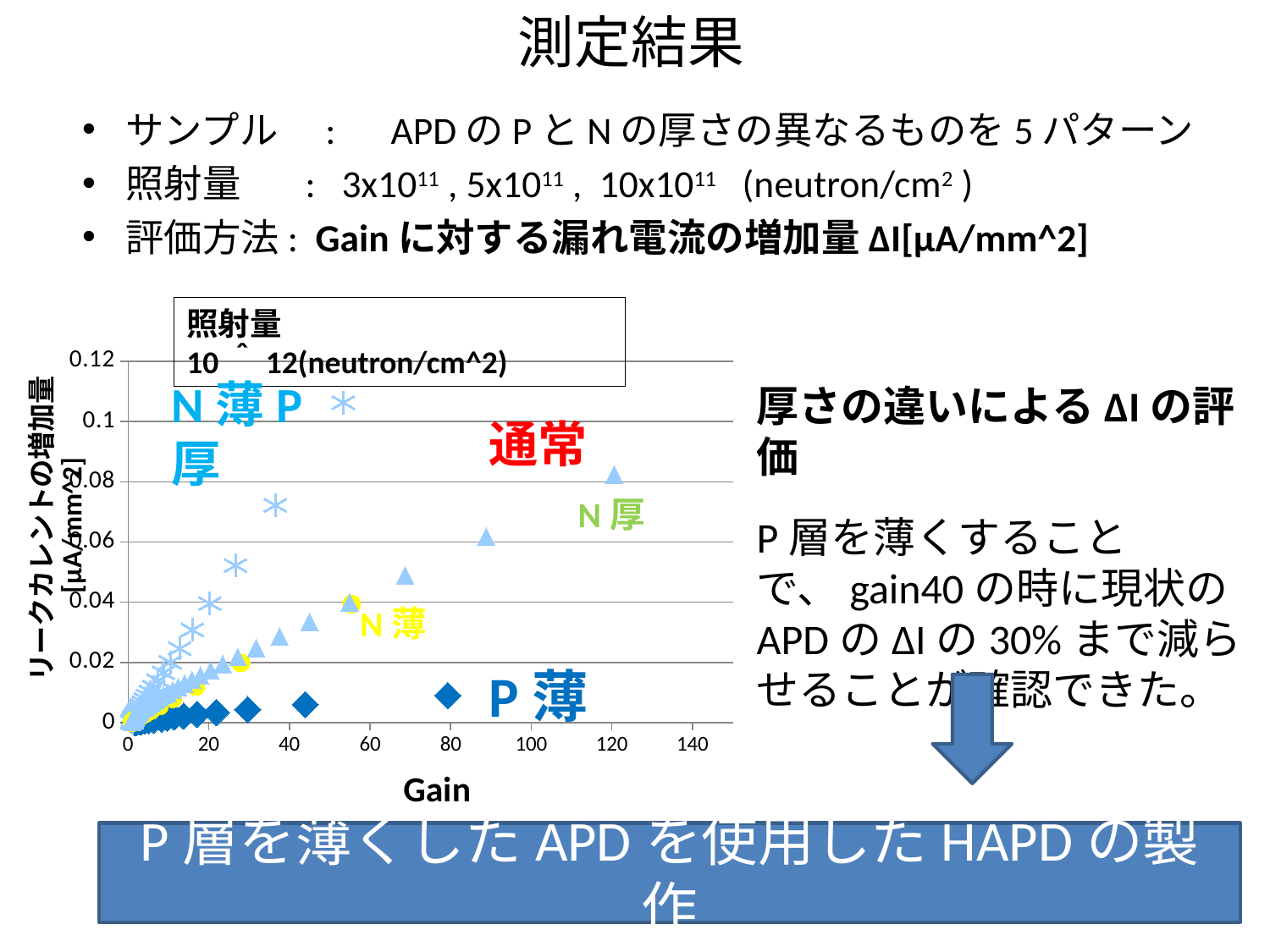
Is the highest point of the N薄P厚 series greater or less than 0.1? greater What kind of chart is shown on the slide? scatter chart Do the ΔI values rise or fall as Gain increases along the x axis? rise At Gain around 55, which series has the larger ΔI: N薄P厚 or N薄? N薄P厚 How many sample types are labelled on the chart? 5 What is the label of the x axis of the chart? Gain Which labelled series has the lowest ΔI values on the chart? P薄 What is the highest tick value shown on the y axis of the chart? 0.12 Which labelled series reaches the highest ΔI values on the chart? N薄P厚 Is the value of the triangle series at Gain 120 greater or less than 0.06? greater What is the highest tick value shown on the x axis of the chart? 140 Is the value for the P薄 series at Gain 80 greater or less than 0.02? less